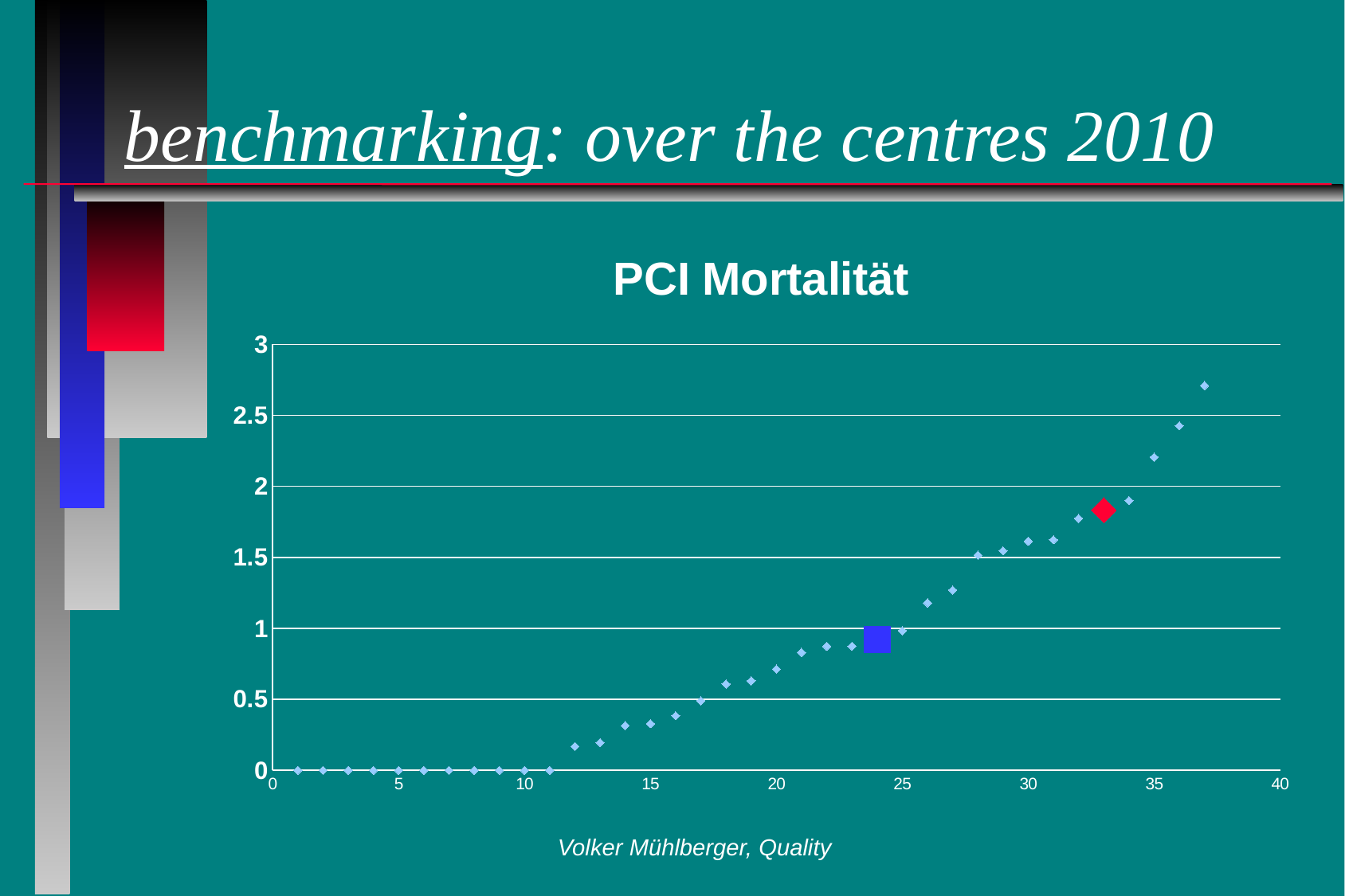
What is the value of the point at x = 5? 0 Is the value of the red diamond marker greater or less than 1.5? greater Which has the larger value, the point at x = 35 or the point at x = 15? x = 35 What is the title of the chart? PCI Mortalität At which x position is the highest plotted point? 37 What kind of chart is shown on the slide? scatter chart Is the value of the point at x = 30 greater or less than 1.5? greater Is the value of the point at x = 37 greater or less than 2.5? greater Do the plotted values rise or fall as the x axis increases from 0 to 40? rise